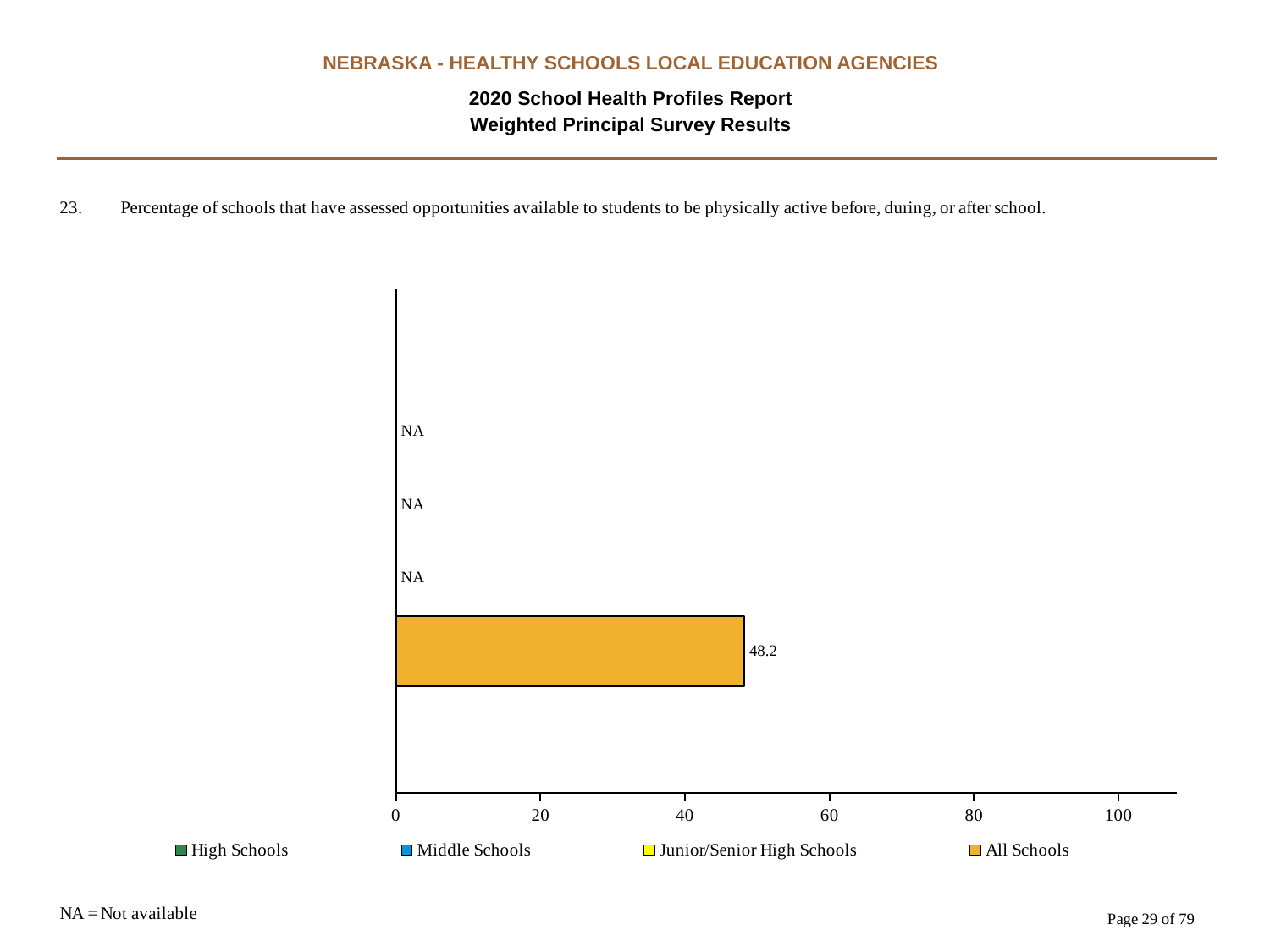
What is the highest value shown on the x axis? 100 Is the value for All Schools greater or less than 40? greater What is the value for All Schools? 48.2 What does NA stand for according to the note on the slide? Not available What value is shown for High Schools? NA What kind of chart is shown on the slide? bar chart What value is shown for Junior/Senior High Schools? NA What value is shown for Middle Schools? NA Is the value for All Schools greater or less than 60? less How many series does the legend list? 4 How many series have a plotted bar with a numeric value? 1